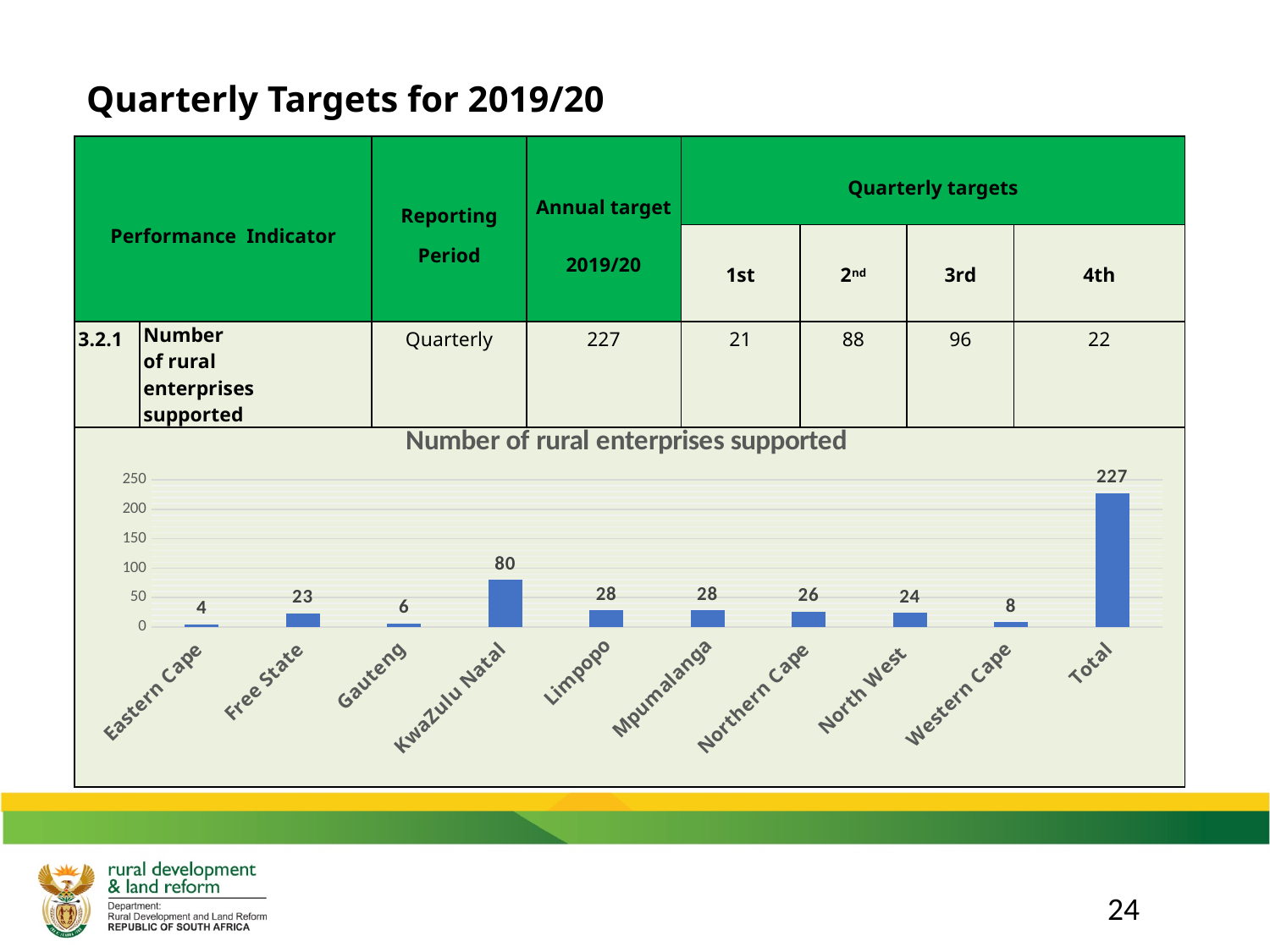
What is the value shown for the Total bar in the chart? 227 What is the value for Western Cape in the chart? 8 What is the title of the chart? Number of rural enterprises supported Which category has the lowest value in the chart? Eastern Cape How many categories are shown on the x axis of the chart? 10 Is the value for the Total bar greater or less than 200? greater Which province has the highest number of rural enterprises supported (excluding the Total bar)? KwaZulu Natal Which is larger, the value for Northern Cape or the value for North West? Northern Cape What is the difference between the values for KwaZulu Natal and Free State? 57 What is the value for KwaZulu Natal in the chart? 80 What kind of chart is shown on the slide? bar chart What is the value for Eastern Cape in the chart? 4